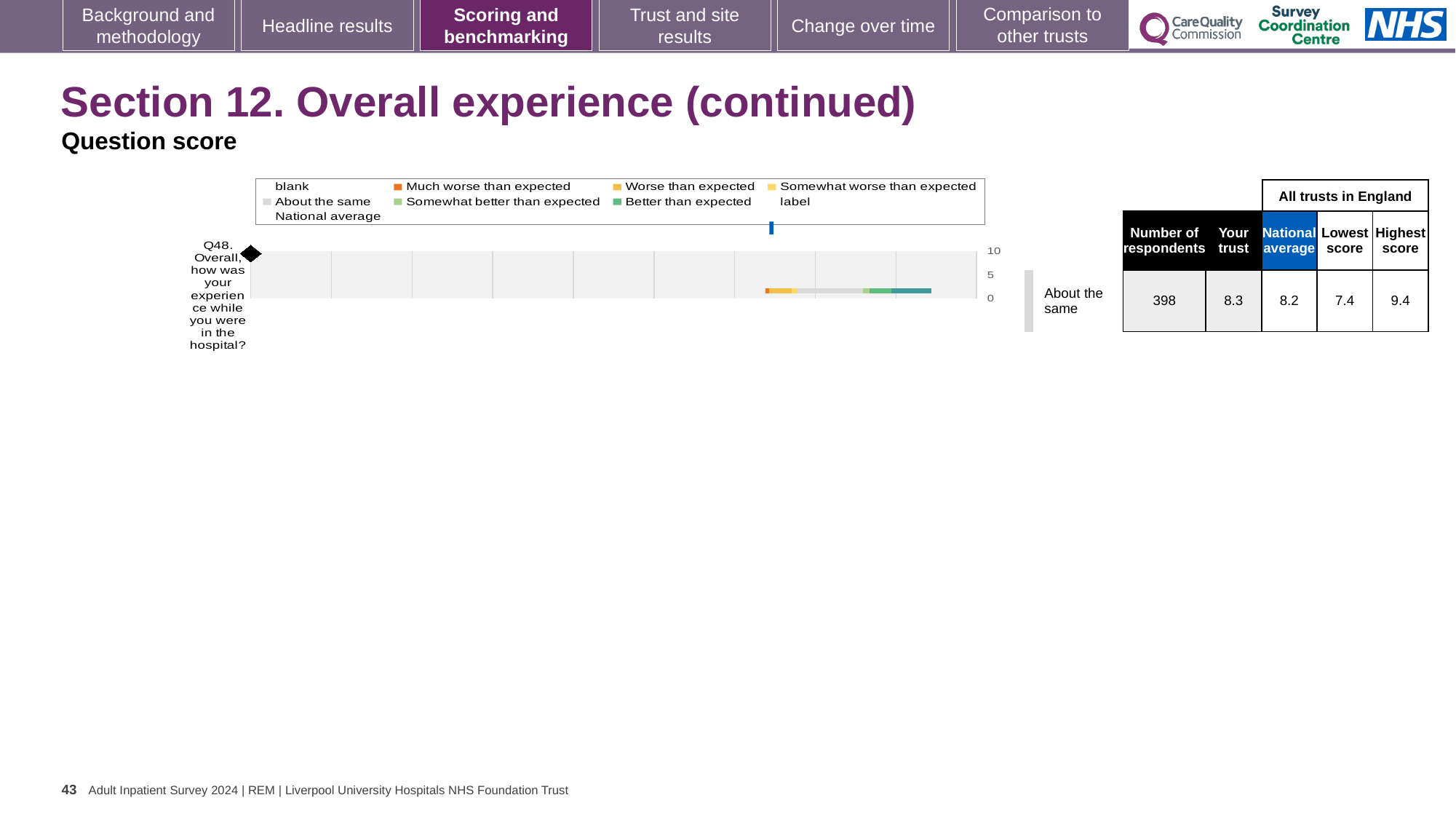
What is the difference between the highest score and the lowest score for Q48? 2.0 Which benchmark category is Q48 placed in? About the same What is the highest score among all trusts in England for Q48? 9.4 What kind of chart is shown on the slide? bar chart How many survey questions are plotted in the chart? 1 What is the difference between the 'Your trust' score and the national average for Q48? 0.1 Which is higher for Q48, the 'Your trust' score or the national average? Your trust What is the national average score for Q48? 8.2 What is the highest value shown on the chart's score axis? 10 How many respondents answered Q48? 398 What is the 'Your trust' score for Q48 (Overall, how was your experience while you were in the hospital?)? 8.3 What is the lowest score among all trusts in England for Q48? 7.4